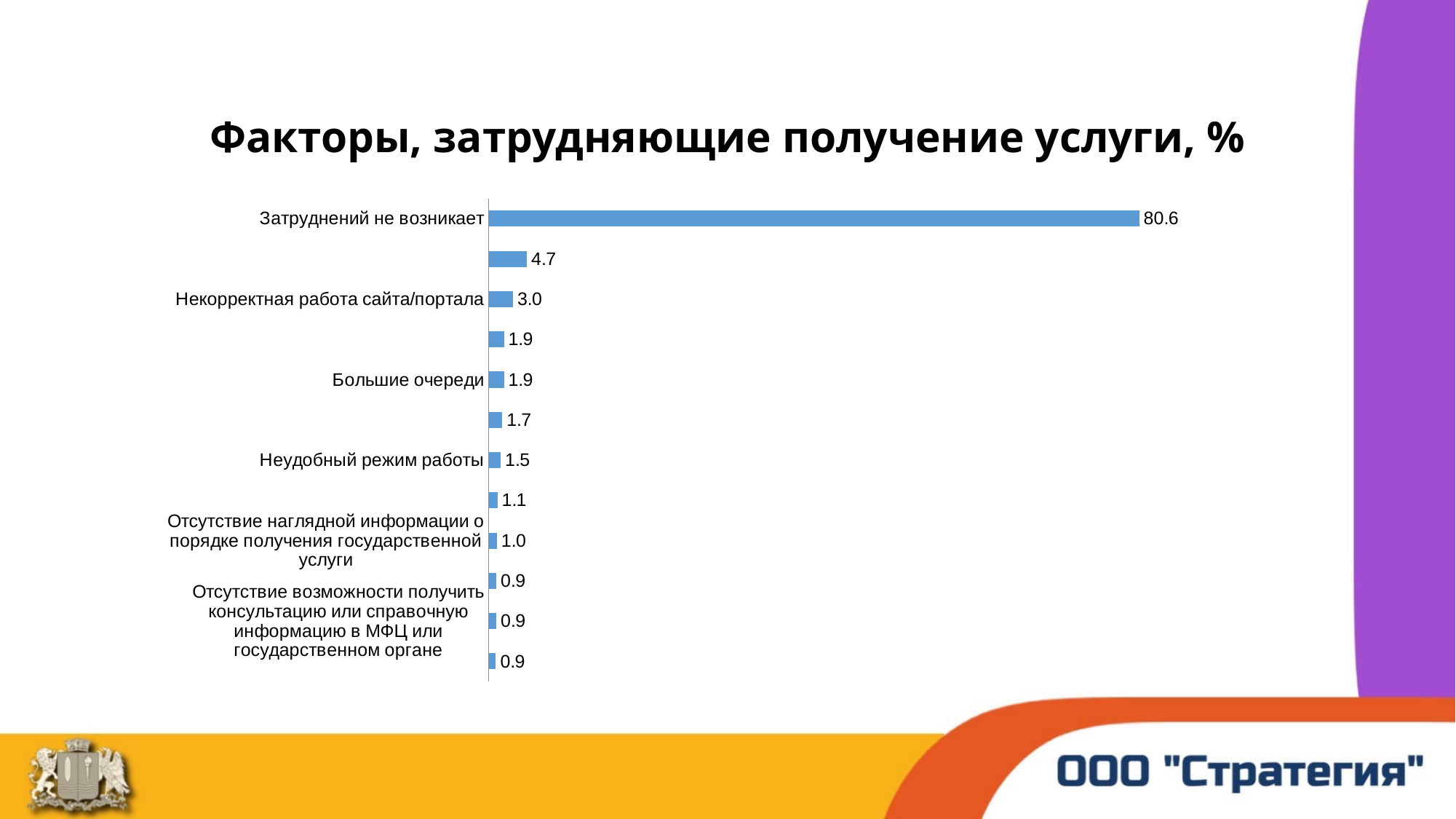
What is the value for "Затруднений не возникает"? 80.6 What is the difference between the values for "Некорректная работа сайта/портала" and "Большие очереди"? 1.1 What is the value for "Неудобный режим работы"? 1.5 How many bars are plotted in the chart? 12 Which is larger: the value for "Большие очереди" or the value for "Неудобный режим работы"? Большие очереди What is the value for "Некорректная работа сайта/портала"? 3.0 What is the value for "Большие очереди"? 1.9 What is the title of the chart? Факторы, затрудняющие получение услуги, % What is the value for "Отсутствие наглядной информации о порядке получения государственной услуги"? 1.0 What kind of chart is shown on the slide? Bar chart What is the difference between the values for "Затруднений не возникает" and "Некорректная работа сайта/портала"? 77.6 Which category has the highest value? Затруднений не возникает